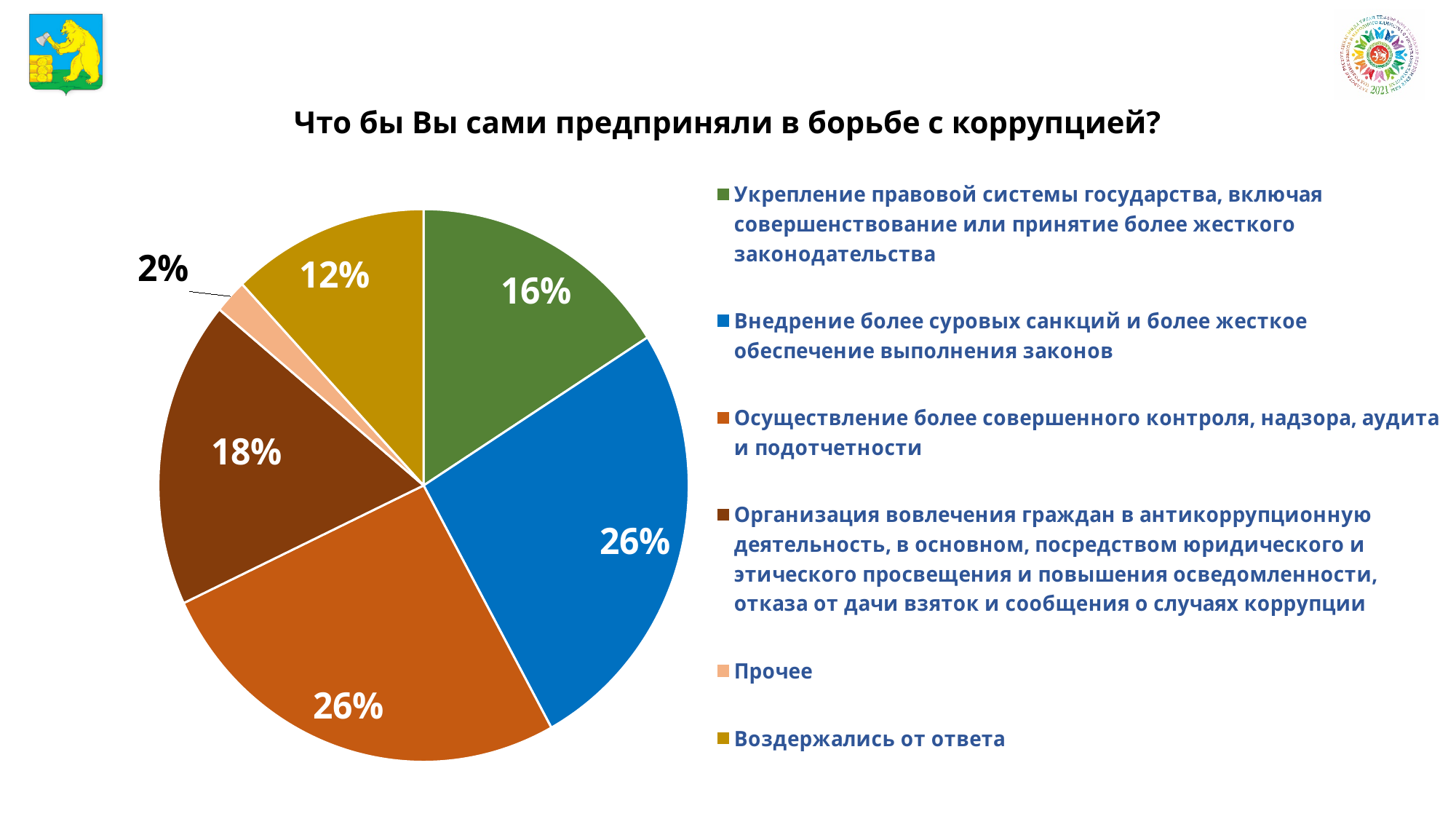
What share of the pie is labelled "Воздержались от ответа"? 12% Which category has the smallest slice of the pie? Прочее What share of the pie corresponds to "Внедрение более суровых санкций и более жесткое обеспечение выполнения законов"? 26% Which is larger: the slice for "Укрепление правовой системы государства..." or the slice for "Организация вовлечения граждан..."? Организация вовлечения граждан... What share of the pie corresponds to "Организация вовлечения граждан в антикоррупционную деятельность..."? 18% What is the difference in percentage points between the "Организация вовлечения граждан..." slice and the "Воздержались от ответа" slice? 6 What kind of chart is shown on the slide? pie chart What is the title of the chart? Что бы Вы сами предприняли в борьбе с коррупцией? How many slices does the pie chart have? 6 What share of the pie is labelled "Прочее"? 2% What share of the pie corresponds to "Укрепление правовой системы государства, включая совершенствование или принятие более жесткого законодательства"? 16% How many entries does the legend list? 6